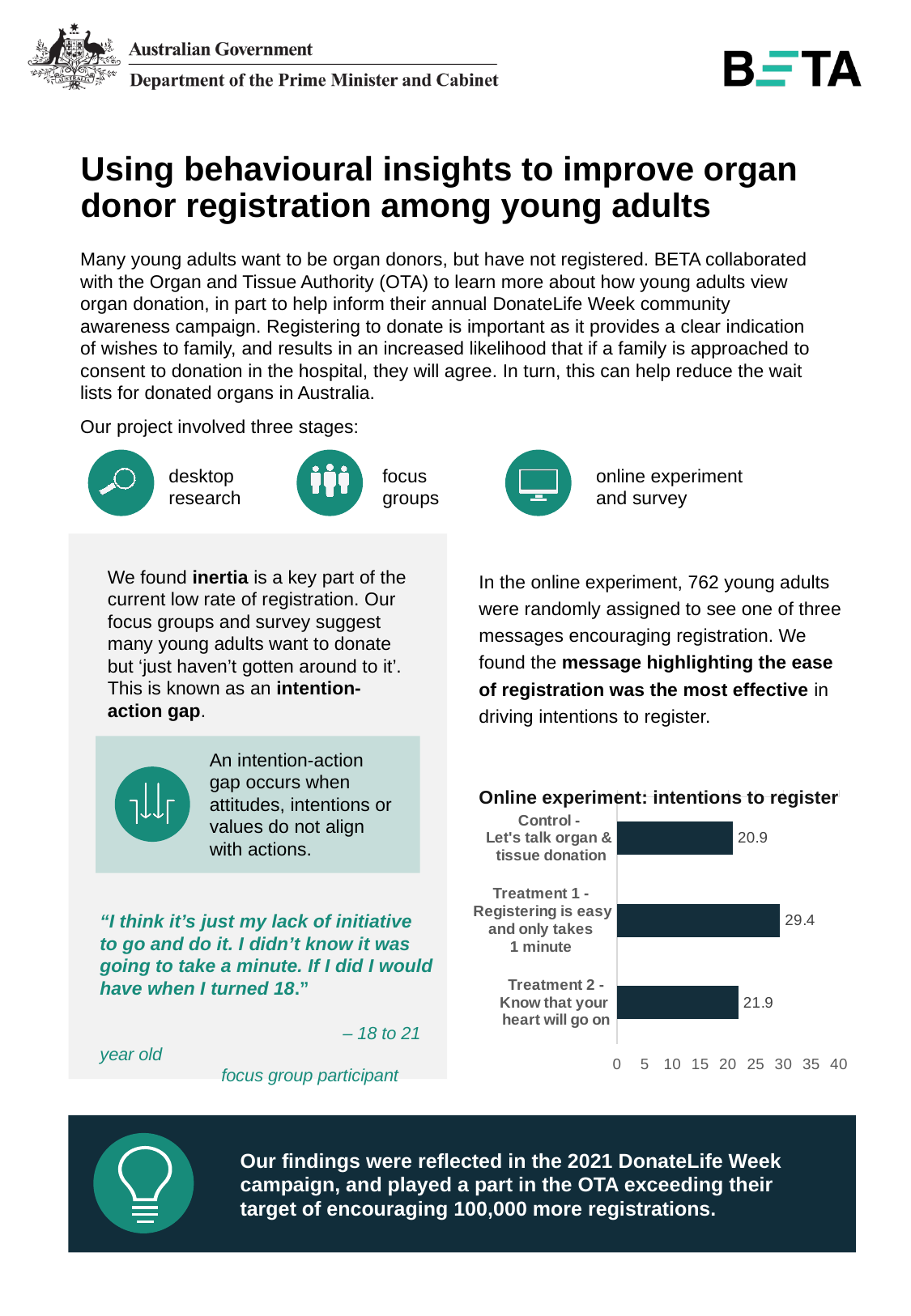
How many categories are shown in the chart? 3 What is the title of the chart? Online experiment: intentions to register Which is larger, the value for Treatment 1 or the value for Treatment 2? Treatment 1 Is the value for Treatment 1 greater or less than 25? greater What is the value for Control - Let's talk organ & tissue donation? 20.9 What is the difference between the values for Treatment 1 and the Control? 8.5 What is the value for Treatment 2 - Know that your heart will go on? 21.9 Which category has the highest value? Treatment 1 - Registering is easy and only takes 1 minute What is the value for Treatment 1 - Registering is easy and only takes 1 minute? 29.4 Which category has the lowest value? Control - Let's talk organ & tissue donation What is the difference between the values for Treatment 2 and the Control? 1.0 What kind of chart is shown on the slide? bar chart